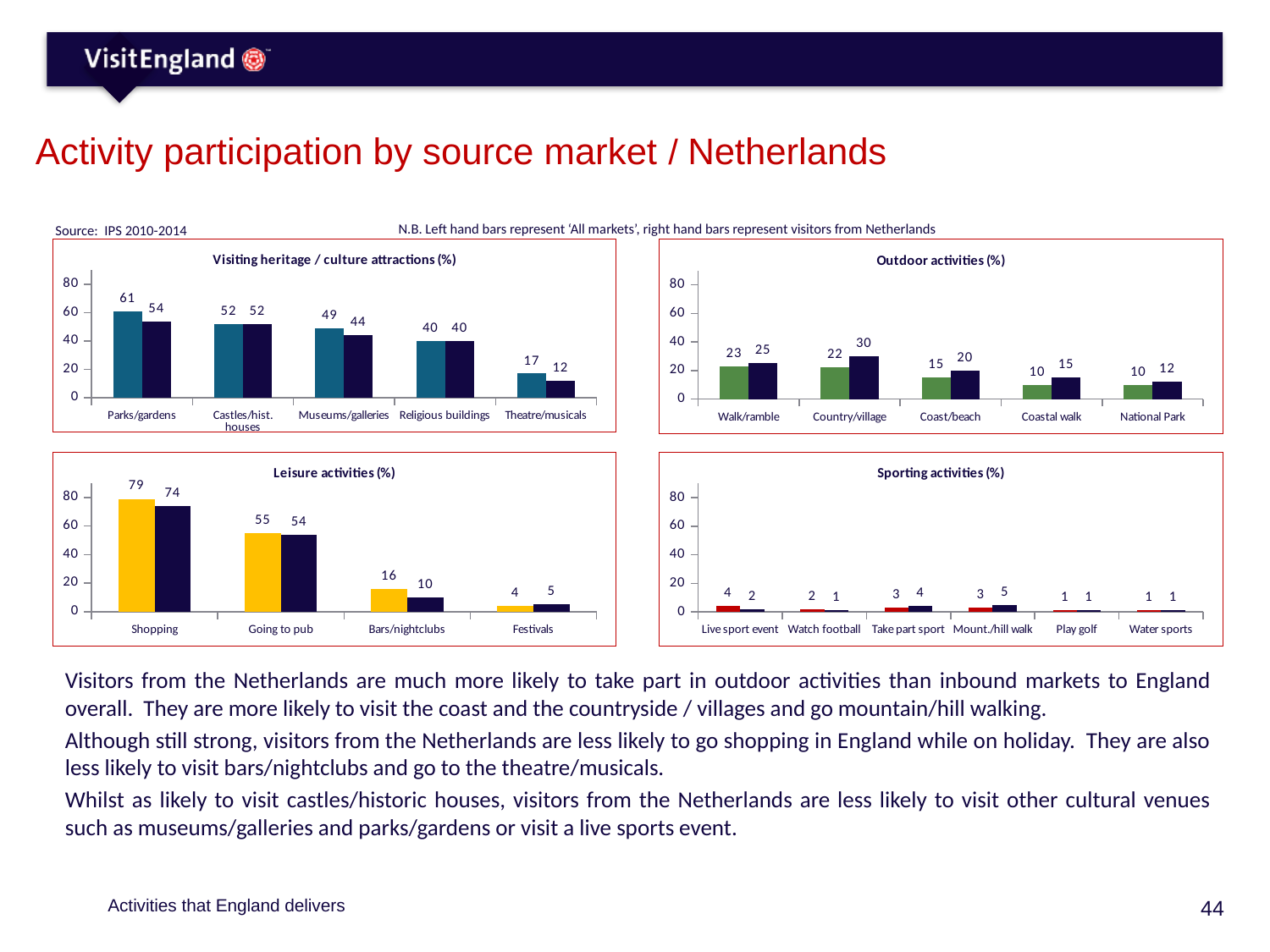
In the 'Leisure activities (%)' chart, which category has the lowest left-hand (All markets) bar? Festivals What type of chart is the 'Outdoor activities (%)' chart? bar chart In the 'Sporting activities (%)' chart, how many categories are shown on the x axis? 6 In the 'Outdoor activities (%)' chart, which category has the highest right-hand (Netherlands) bar? Country/village In the 'Leisure activities (%)' chart, what is the difference between the left-hand and right-hand bars for Bars/nightclubs? 6 In the 'Outdoor activities (%)' chart, what is the value of the right-hand (Netherlands) bar for Country/village? 30 In the 'Visiting heritage / culture attractions (%)' chart, what is the value of the left-hand (All markets) bar for Theatre/musicals? 17 In the 'Visiting heritage / culture attractions (%)' chart, is the left-hand bar for Museums/galleries larger or smaller than the right-hand bar? larger In the 'Sporting activities (%)' chart, what is the value of the right-hand (Netherlands) bar for Mount./hill walk? 5 In the 'Leisure activities (%)' chart, is the value of the left-hand bar for Shopping greater or less than 60? greater In the 'Visiting heritage / culture attractions (%)' chart, what is the value of the right-hand (Netherlands) bar for Parks/gardens? 54 How many charts are shown on the slide? 4